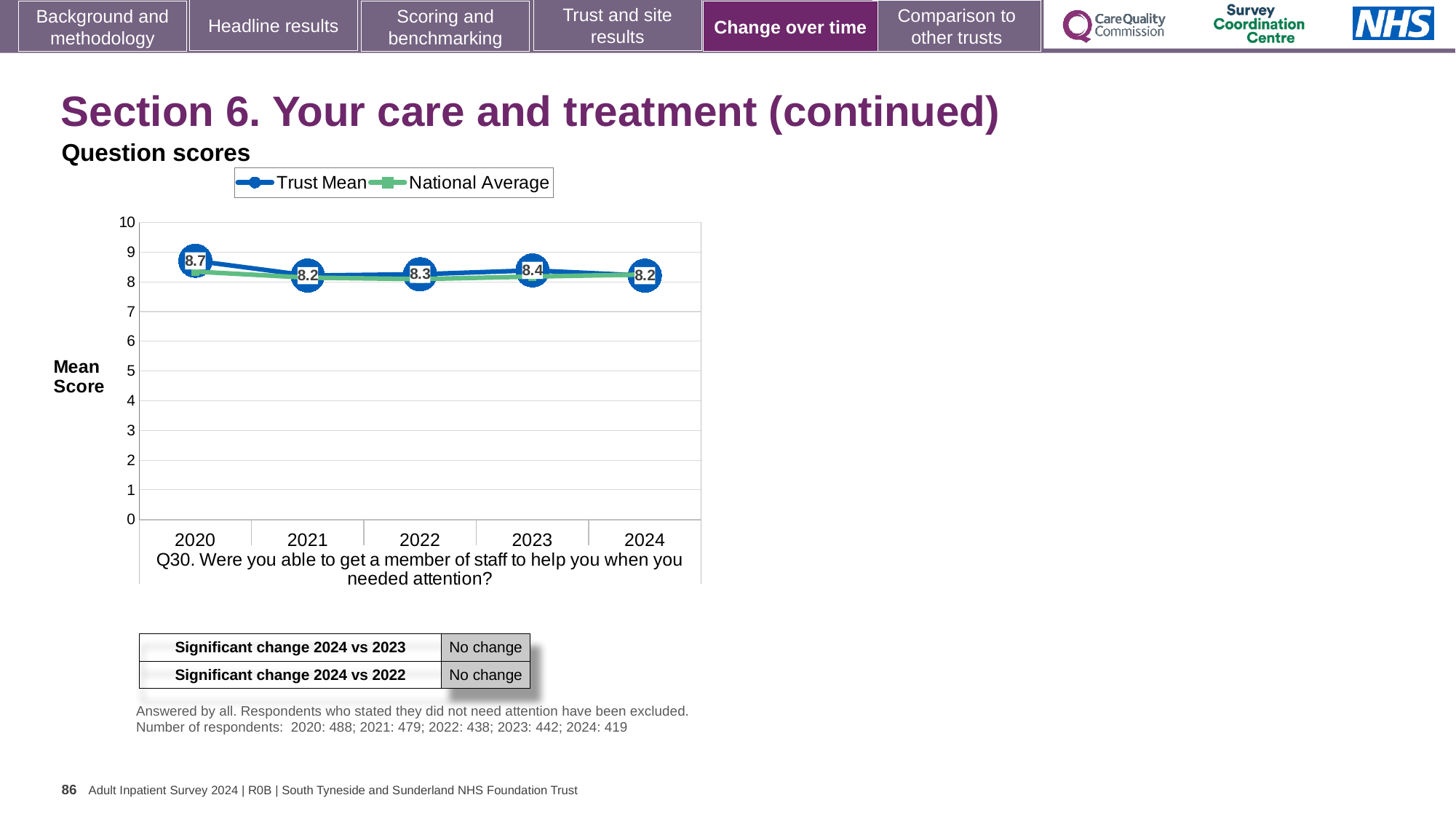
Is the National Average value for 2020 greater or less than 9? less Does the Trust Mean score rise or fall from 2020 to 2021? Fall How many years are plotted on the x axis? 5 What kind of chart is shown? Line chart Is the National Average value for 2024 greater or less than 7? greater Which is larger, the Trust Mean score for 2020 or for 2023? 2020 What is the Trust Mean score for 2023? 8.4 What is the Trust Mean score for 2020? 8.7 How many series does the legend list? 2 In which year is the Trust Mean score highest? 2020 What is the difference between the Trust Mean scores for 2020 and 2021? 0.5 What is the Trust Mean score for 2024? 8.2